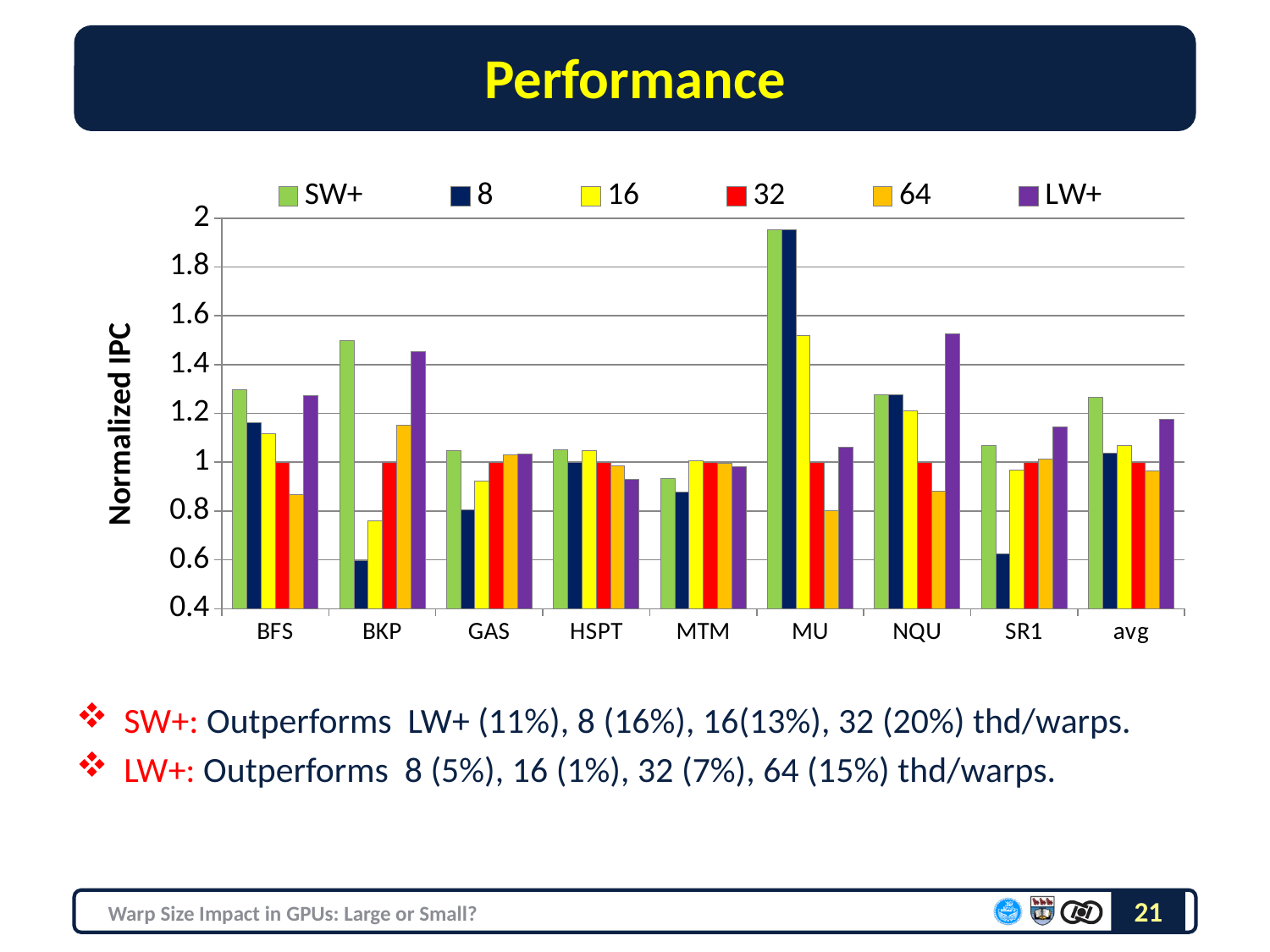
How many categories are shown along the x axis? 9 What kind of chart is shown on the slide? bar chart Which category has the lowest SW+ value? MTM What is the label of the y axis? Normalized IPC For NQU, which is larger: the SW+ value or the LW+ value? LW+ How many series does the legend list? 6 Which category has the highest SW+ value? MU Is the value of the 16 series for BKP greater or less than 0.8? less Is the value of the 64 series for MU greater or less than 1? less Which category has the highest value for the 16 series? MU Is the SW+ value for BKP greater or less than 1.4? greater For BFS, which is larger: the SW+ value or the value of the 8 series? SW+